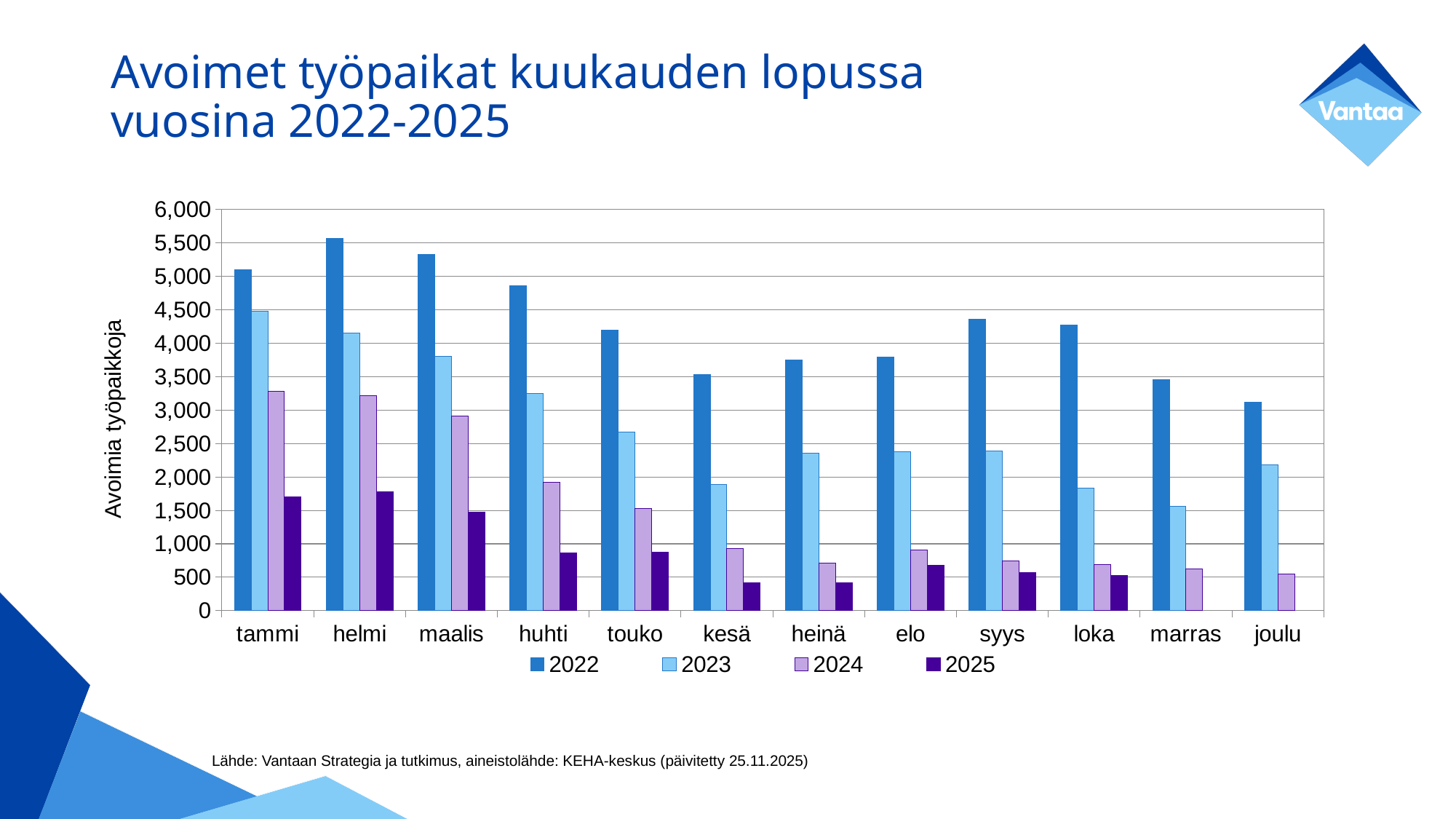
What kind of chart is shown on the slide? bar chart For helmi, which is larger: the 2022 value or the 2023 value? 2022 Is the 2022 value for tammi greater or less than 5,000? greater Is the 2025 value for helmi greater or less than 1,500? greater In which month is the 2022 value lowest? joulu In which month is the 2022 value highest? helmi How many months are shown on the x axis? 12 What is the label on the y axis? Avoimia työpaikkoja Is the 2023 value for kesä greater or less than 2,000? less Do the 2024 values generally rise or fall from tammi to joulu? fall How many series does the legend list? 4 In which month is the 2023 value lowest? marras